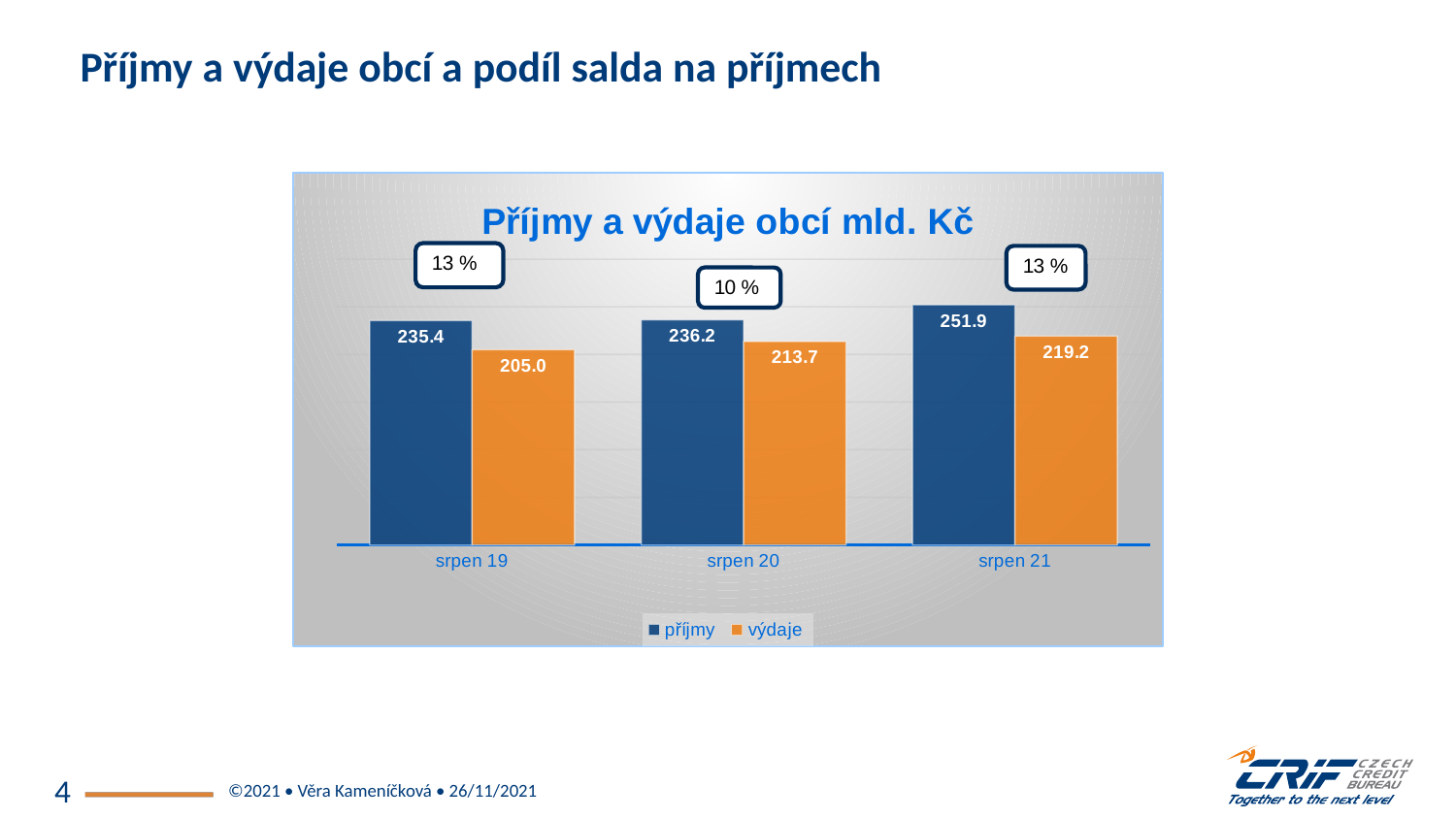
What kind of chart is shown? bar chart What is the difference between příjmy and výdaje for srpen 21? 32.7 How many periods are shown on the x axis? 3 Which is larger for srpen 20: příjmy or výdaje? příjmy What is the value of výdaje for srpen 19? 205.0 What is the value of výdaje for srpen 20? 213.7 How many series does the legend list? 2 Which period has the highest příjmy value? srpen 21 What is the value of příjmy for srpen 21? 251.9 What is the value of příjmy for srpen 19? 235.4 Which period has the lowest výdaje value? srpen 19 Do the výdaje values rise or fall from srpen 19 to srpen 21? rise